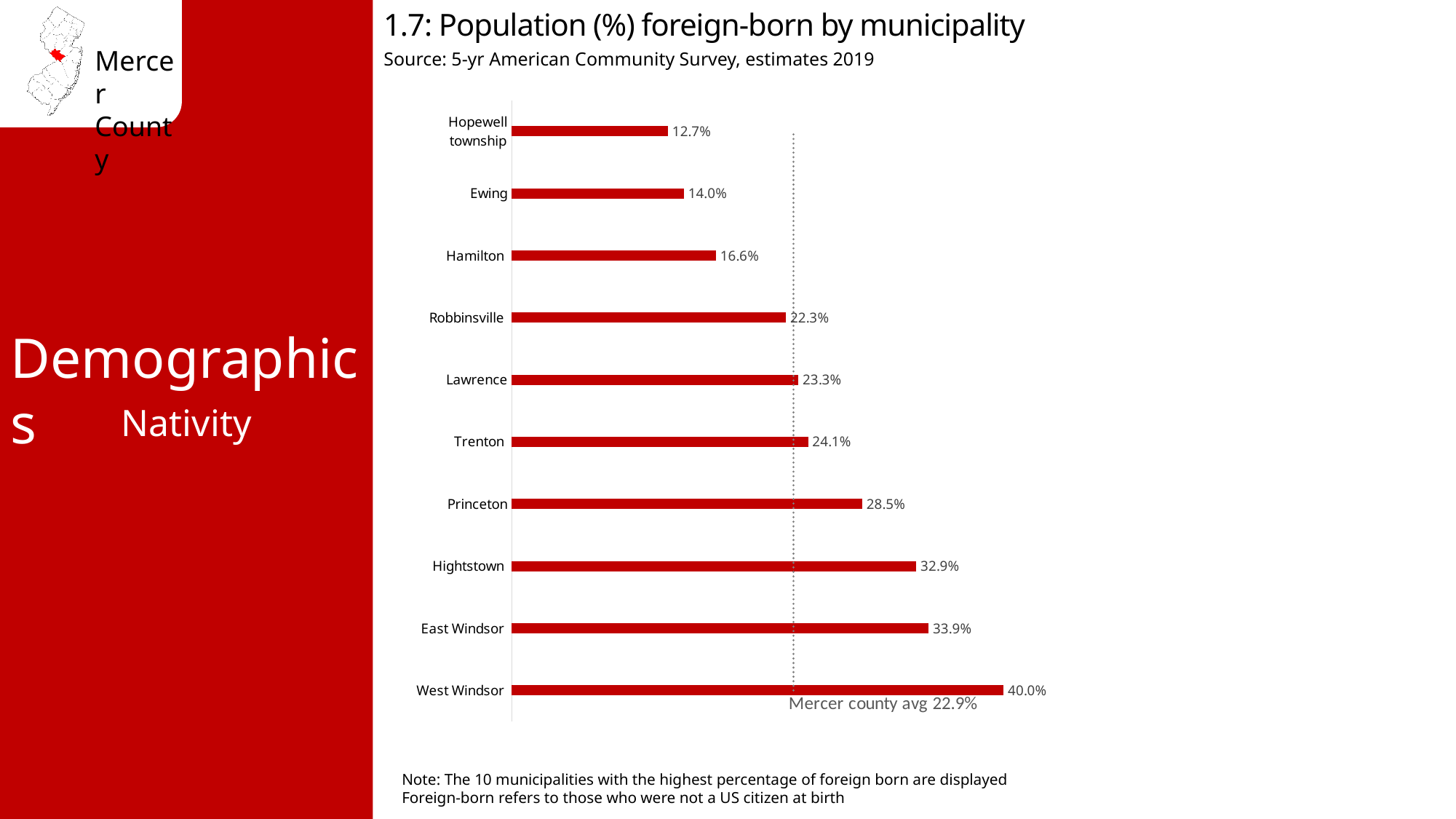
What is the difference in foreign-born percentage between West Windsor and Hopewell township? 27.3% What is the difference in foreign-born percentage between East Windsor and Hightstown? 1.0% Which municipality has the highest percentage of foreign-born population? West Windsor What type of chart is used to show the foreign-born population by municipality? Bar chart What is the Mercer county average foreign-born percentage marked by the dotted line? 22.9% Which has a higher foreign-born percentage, Princeton or Lawrence? Princeton What is the foreign-born population percentage for West Windsor? 40.0% What is the foreign-born population percentage for Trenton? 24.1% Which municipality has the lowest percentage of foreign-born population? Hopewell township What is the foreign-born population percentage for Hamilton? 16.6% Which has a higher foreign-born percentage, Ewing or Robbinsville? Robbinsville How many municipalities are shown in the chart? 10